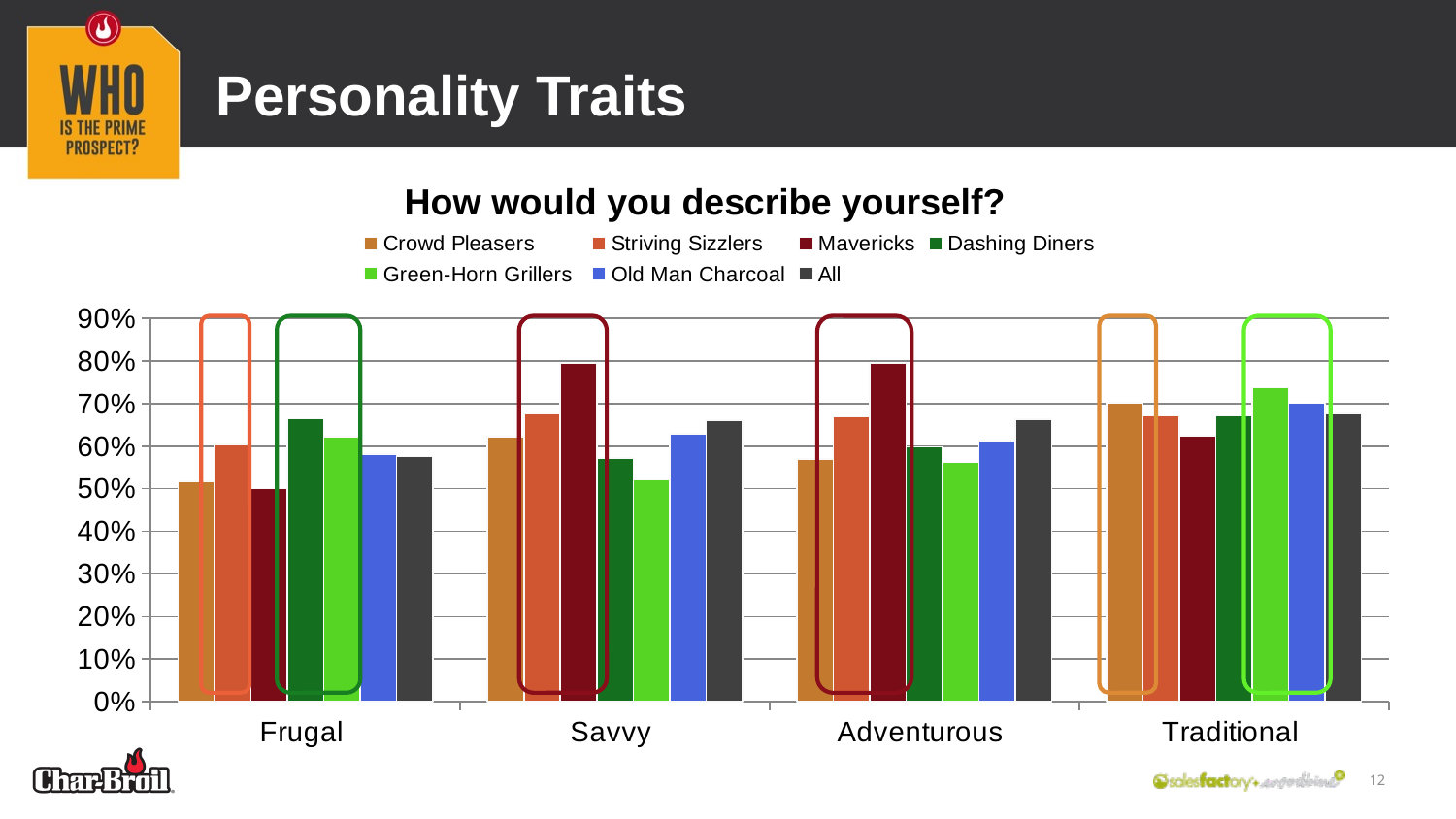
How many personality trait categories are shown on the x axis? 4 What is the title of the chart? How would you describe yourself? What kind of chart is shown on the slide? bar chart Which series has the lowest value for Savvy? Green-Horn Grillers Which series has the highest value for Frugal? Dashing Diners Is the value for Crowd Pleasers in the Frugal category greater or less than 60%? less Which series has the highest value for Adventurous? Mavericks In the Adventurous category, which is larger: Mavericks or Crowd Pleasers? Mavericks Which series has the highest value for Savvy? Mavericks Is the value for Green-Horn Grillers in the Savvy category greater or less than 60%? less How many series does the legend list? 7 Is the value for Mavericks in the Savvy category greater or less than 70%? greater